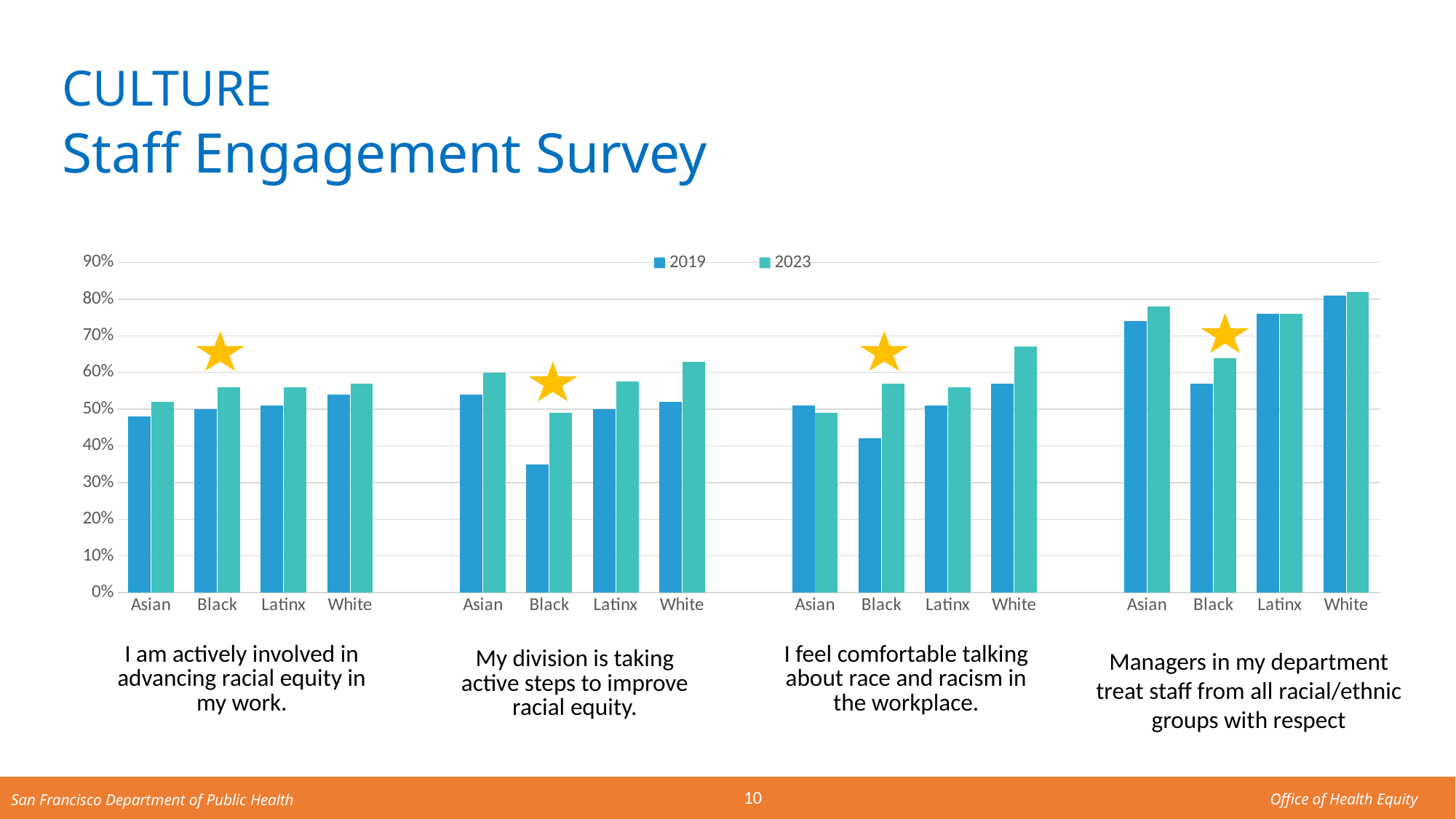
What are the two series named in the legend? 2019 and 2023 For 'I feel comfortable talking about race and racism in the workplace', is the 2023 value for White greater or less than 60%? greater For 'Managers in my department treat staff from all racial/ethnic groups with respect', is the 2023 value for White greater or less than 80%? greater For 'Managers in my department treat staff from all racial/ethnic groups with respect', which group has the highest 2023 value? White For 'My division is taking active steps to improve racial equity', is the 2019 value for Black greater or less than 40%? less For 'My division is taking active steps to improve racial equity', which group has the lowest 2019 value? Black How many survey statements are shown along the bottom of the chart? 4 For 'I am actively involved in advancing racial equity in my work', which is larger in 2019: the value for White or the value for Black? White How many series does the legend list? 2 How many racial/ethnic groups are shown for each survey statement? 4 For 'I feel comfortable talking about race and racism in the workplace', which is larger for Black: the 2019 value or the 2023 value? 2023 What kind of chart is shown on the slide? bar chart